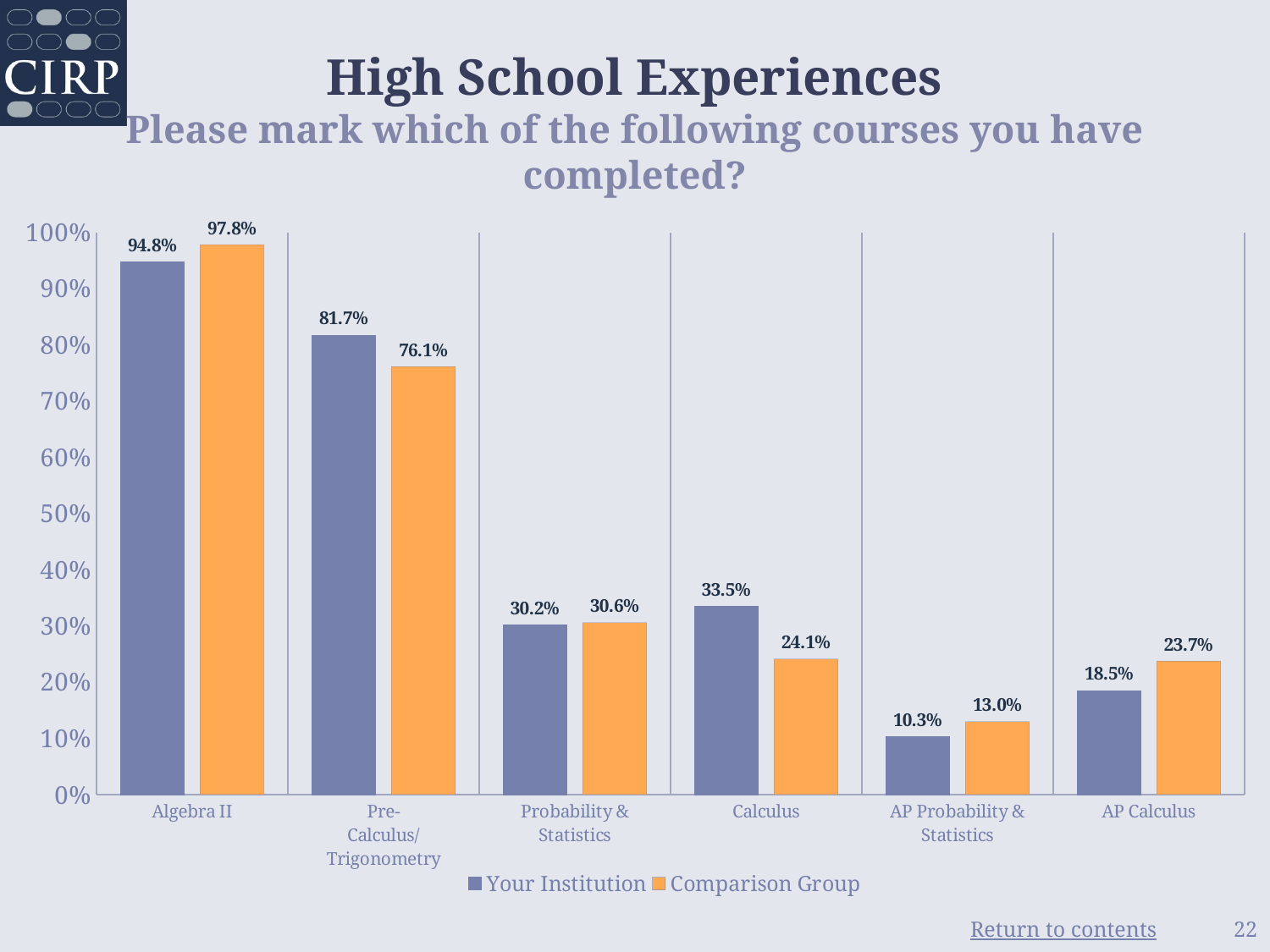
Which course has the lowest Your Institution value? AP Probability & Statistics What kind of chart is shown on the slide? Bar chart Which course has the highest Comparison Group value? Algebra II What percentage of Your Institution students completed Algebra II? 94.8% What is the Your Institution value for AP Probability & Statistics? 10.3% What is the Comparison Group value for AP Calculus? 23.7% For AP Calculus, which is larger: Your Institution or Comparison Group? Comparison Group Is the Your Institution value for Pre-Calculus/Trigonometry greater or less than 80%? greater What is the difference between the Your Institution and Comparison Group values for Calculus? 9.4% How many series does the legend list? 2 What is the difference between the Comparison Group and Your Institution values for Pre-Calculus/Trigonometry? 5.6% How many courses are shown on the x axis? 6